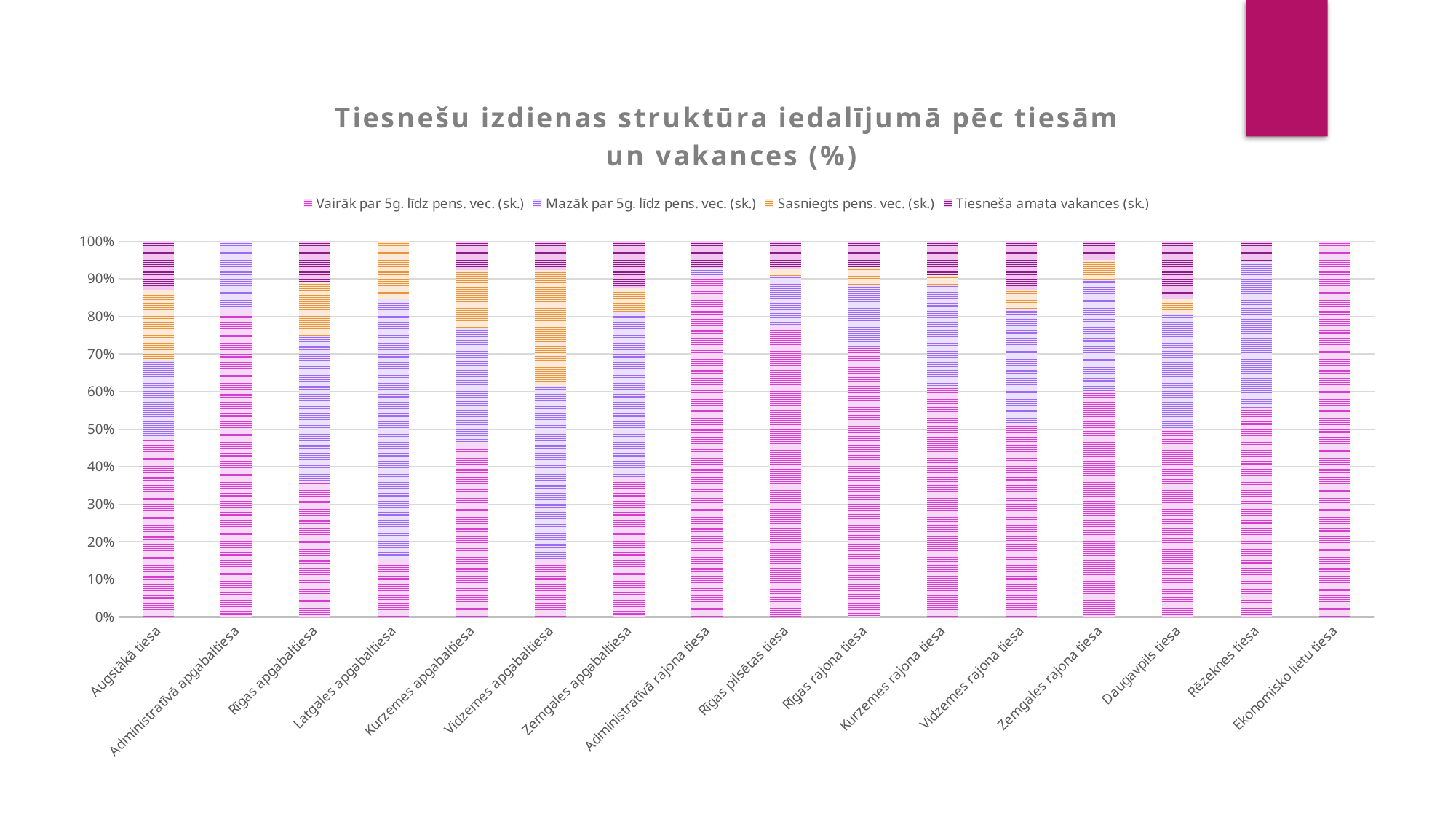
What is the title of the chart? Tiesnešu izdienas struktūra iedalījumā pēc tiesām un vakances (%) What kind of chart is shown on the slide? Stacked bar chart Which court has the larger share of 'Vairāk par 5g. līdz pens. vec. (sk.)': Administratīvā apgabaltiesa or Augstākā tiesa? Administratīvā apgabaltiesa How many series does the chart legend list? 4 How many courts (categories) are shown on the x axis of the chart? 16 Which series in the legend is shown in orange? Sasniegts pens. vec. (sk.) Is the share of 'Vairāk par 5g. līdz pens. vec. (sk.)' for Ekonomisko lietu tiesa greater or less than 90%? greater Is the share of 'Vairāk par 5g. līdz pens. vec. (sk.)' for Vidzemes apgabaltiesa greater or less than 20%? less Which court has the largest share for 'Sasniegts pens. vec. (sk.)'? Vidzemes apgabaltiesa Which court has the largest share for 'Vairāk par 5g. līdz pens. vec. (sk.)'? Ekonomisko lietu tiesa Which court has the larger share of 'Sasniegts pens. vec. (sk.)': Vidzemes apgabaltiesa or Rīgas pilsētas tiesa? Vidzemes apgabaltiesa Is the share of 'Vairāk par 5g. līdz pens. vec. (sk.)' for Administratīvā apgabaltiesa greater or less than 70%? greater